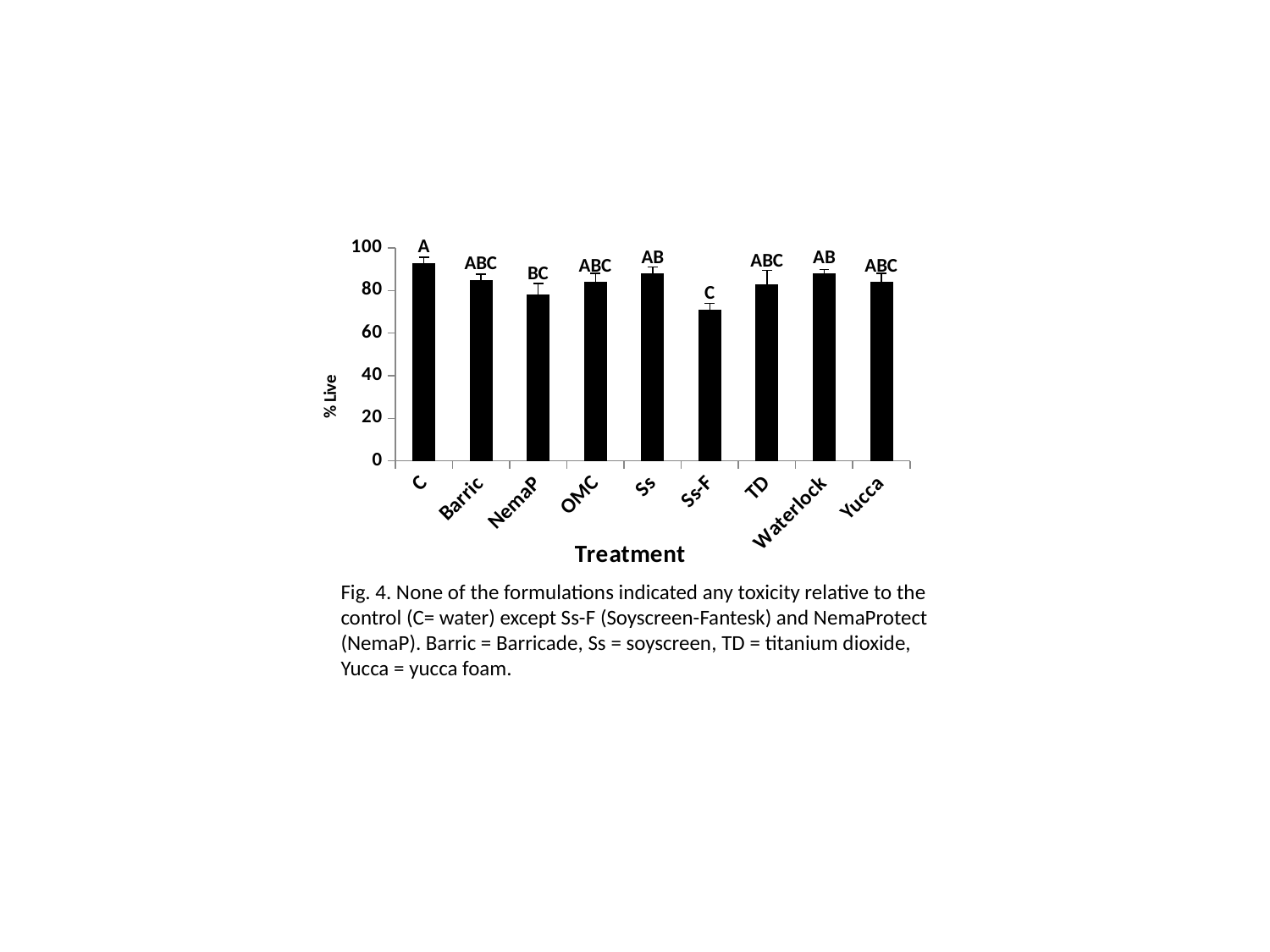
How many treatments are plotted on the x axis? 9 Which treatment has the highest % Live? C Is the value for Waterlock greater or less than 100? less Which has a higher % Live, NemaP or Ss? Ss Is the value for NemaP greater or less than 60? greater Is the value for C greater or less than 80? greater Which treatment has the lowest % Live? Ss-F Which has a higher % Live, C or Ss-F? C What is the label of the x axis? Treatment What letter group is printed above the Ss-F bar? C What kind of chart is shown on the slide? bar chart